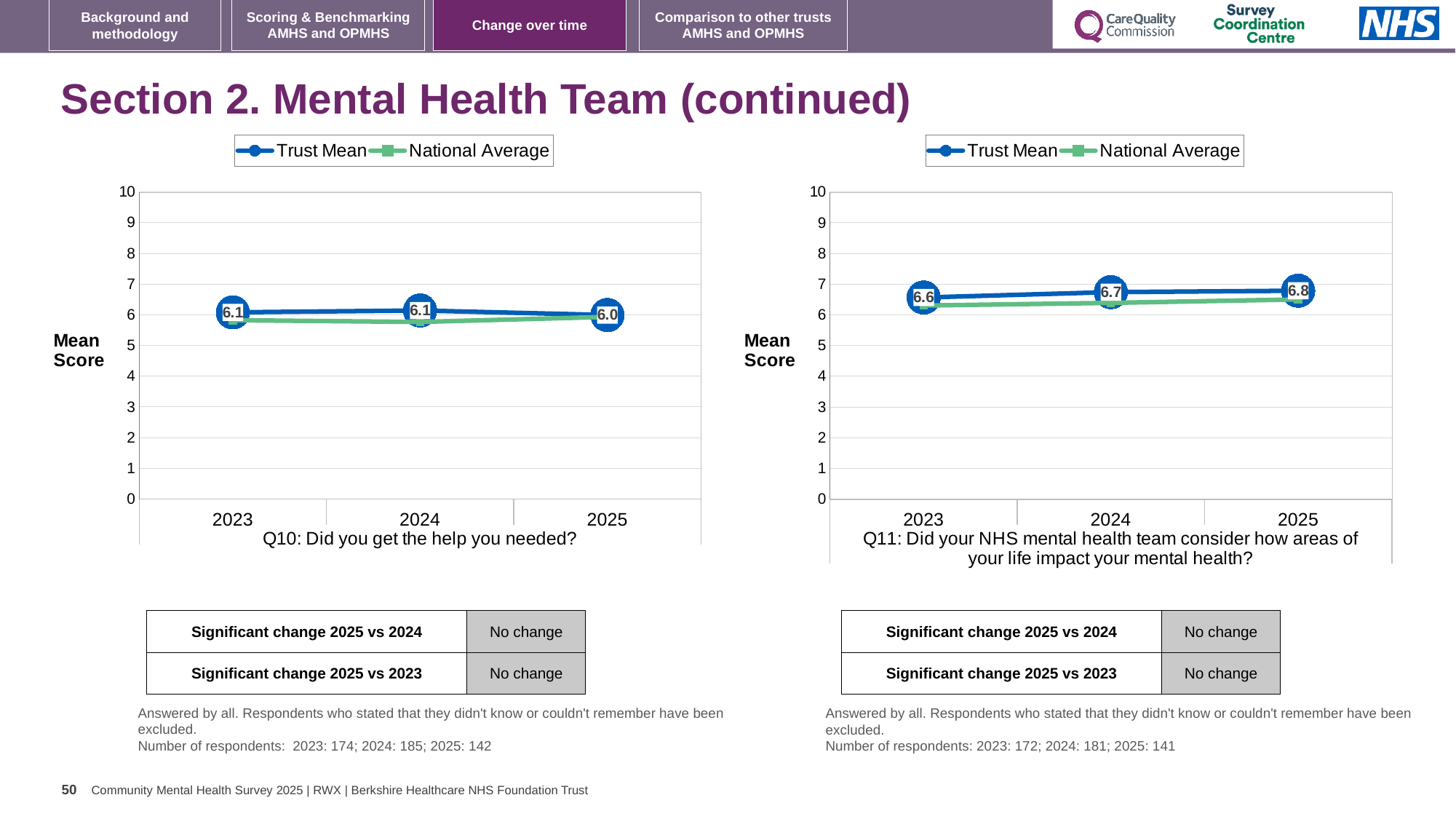
What kind of chart is the Q11 chart? line chart In the Q11 chart, which year has the highest Trust Mean? 2025 In the Q11 chart, what is the Trust Mean for 2024? 6.7 In the Q11 chart, which year has the lowest Trust Mean? 2023 In the Q10 chart, is the National Average for 2023 greater or less than 7? less In the Q11 chart, does the Trust Mean rise or fall from 2023 to 2025? rise In the Q11 chart, what is the difference between the Trust Mean for 2025 and 2023? 0.2 In the Q10 chart, what is the Trust Mean for 2023? 6.1 In the Q10 chart, is the Trust Mean for 2024 larger than the Trust Mean for 2025? Yes In the Q11 chart, what is the Trust Mean for 2025? 6.8 How many series does the legend of the Q10 chart list? 2 In the Q10 chart, what is the Trust Mean for 2025? 6.0